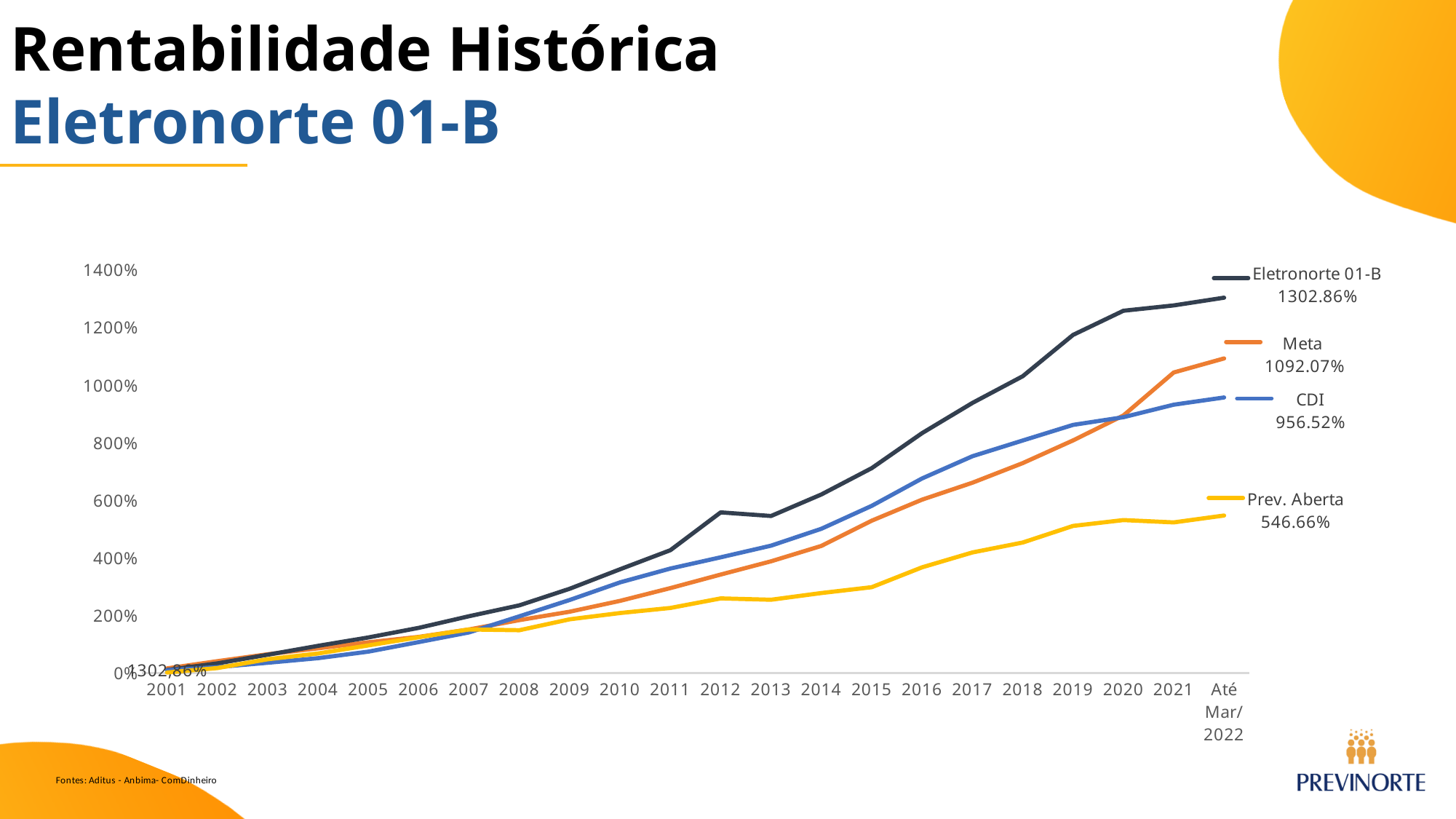
What is the difference between the final values of Eletronorte 01-B and Meta? 210.79% What is the final value shown for the Prev. Aberta series? 546.66% What is the final value shown for the Meta series? 1092.07% What is the final value shown for the Eletronorte 01-B series? 1302.86% Which series has the highest final value? Eletronorte 01-B Do the values of the Eletronorte 01-B series generally rise or fall from 2001 to Mar/2022? Rise What is the final value shown for the CDI series? 956.52% Which series has the lowest final value? Prev. Aberta How many series does the legend list? 4 Which has a larger final value, CDI or Prev. Aberta? CDI Is the value for Eletronorte 01-B in 2012 greater or less than 400%? greater What kind of chart is shown on the slide? Line chart